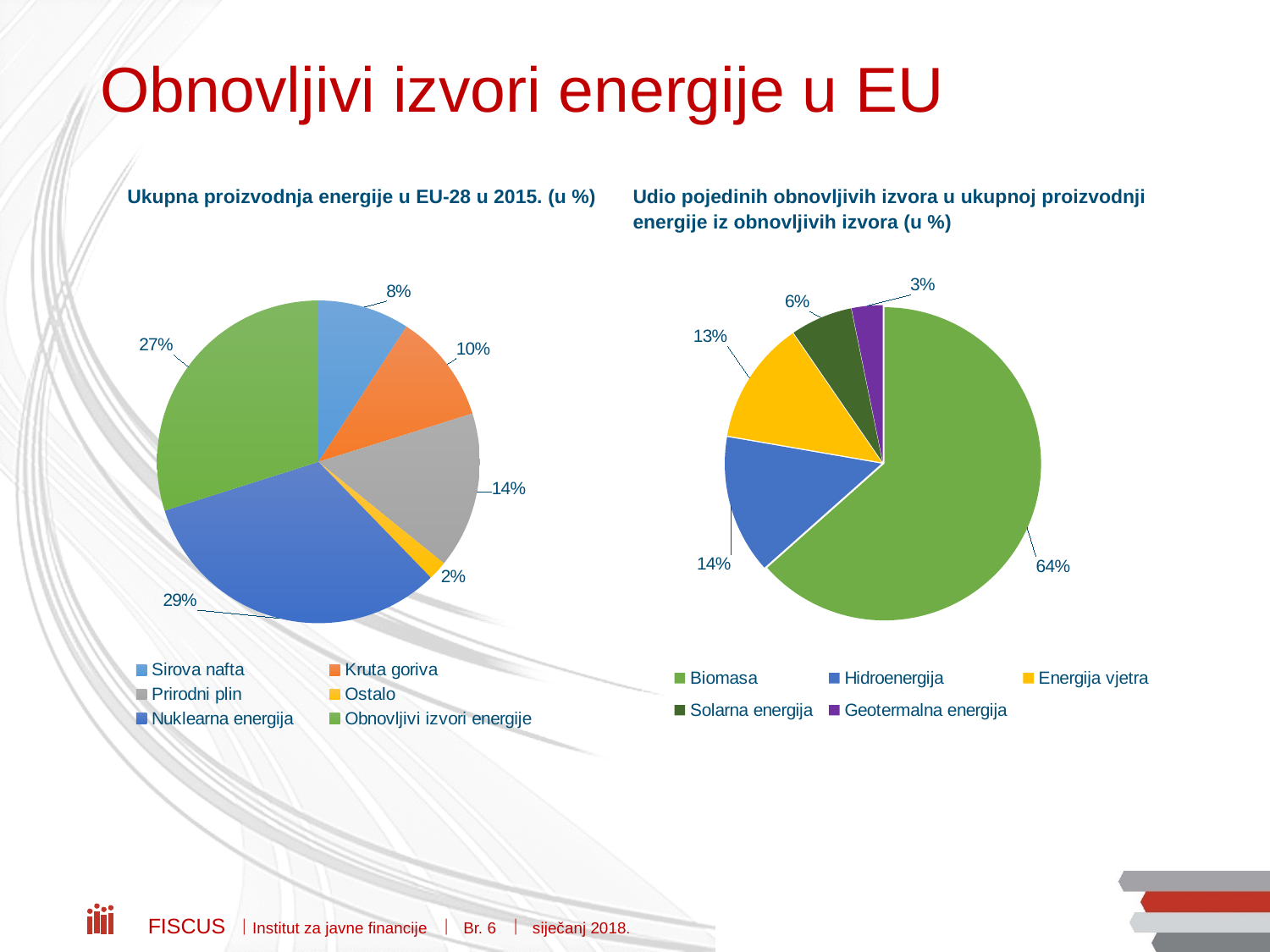
In the chart 'Ukupna proizvodnja energije u EU-28 u 2015. (u %)', which category has the largest share? Nuklearna energija In the chart 'Ukupna proizvodnja energije u EU-28 u 2015. (u %)', what is the difference in percentage points between Prirodni plin and Sirova nafta? 6 In the chart 'Udio pojedinih obnovljivih izvora u ukupnoj proizvodnji energije iz obnovljivih izvora (u %)', what share does Biomasa have? 64% In the chart 'Ukupna proizvodnja energije u EU-28 u 2015. (u %)', what share does Obnovljivi izvori energije have? 27% In the chart 'Udio pojedinih obnovljivih izvora u ukupnoj proizvodnji energije iz obnovljivih izvora (u %)', which source has the largest share? Biomasa In the chart 'Ukupna proizvodnja energije u EU-28 u 2015. (u %)', how many categories does the legend list? 6 In the chart 'Udio pojedinih obnovljivih izvora u ukupnoj proizvodnji energije iz obnovljivih izvora (u %)', what share does Geotermalna energija have? 3% In the chart 'Udio pojedinih obnovljivih izvora u ukupnoj proizvodnji energije iz obnovljivih izvora (u %)', which is larger, Hidroenergija or Solarna energija? Hidroenergija In the chart 'Udio pojedinih obnovljivih izvora u ukupnoj proizvodnji energije iz obnovljivih izvora (u %)', what is the difference in percentage points between Biomasa and Hidroenergija? 50 In the chart 'Ukupna proizvodnja energije u EU-28 u 2015. (u %)', which category has the smallest share? Ostalo In the chart 'Ukupna proizvodnja energije u EU-28 u 2015. (u %)', what share does Nuklearna energija have? 29% What type of chart is used on the right side of the slide? Pie chart